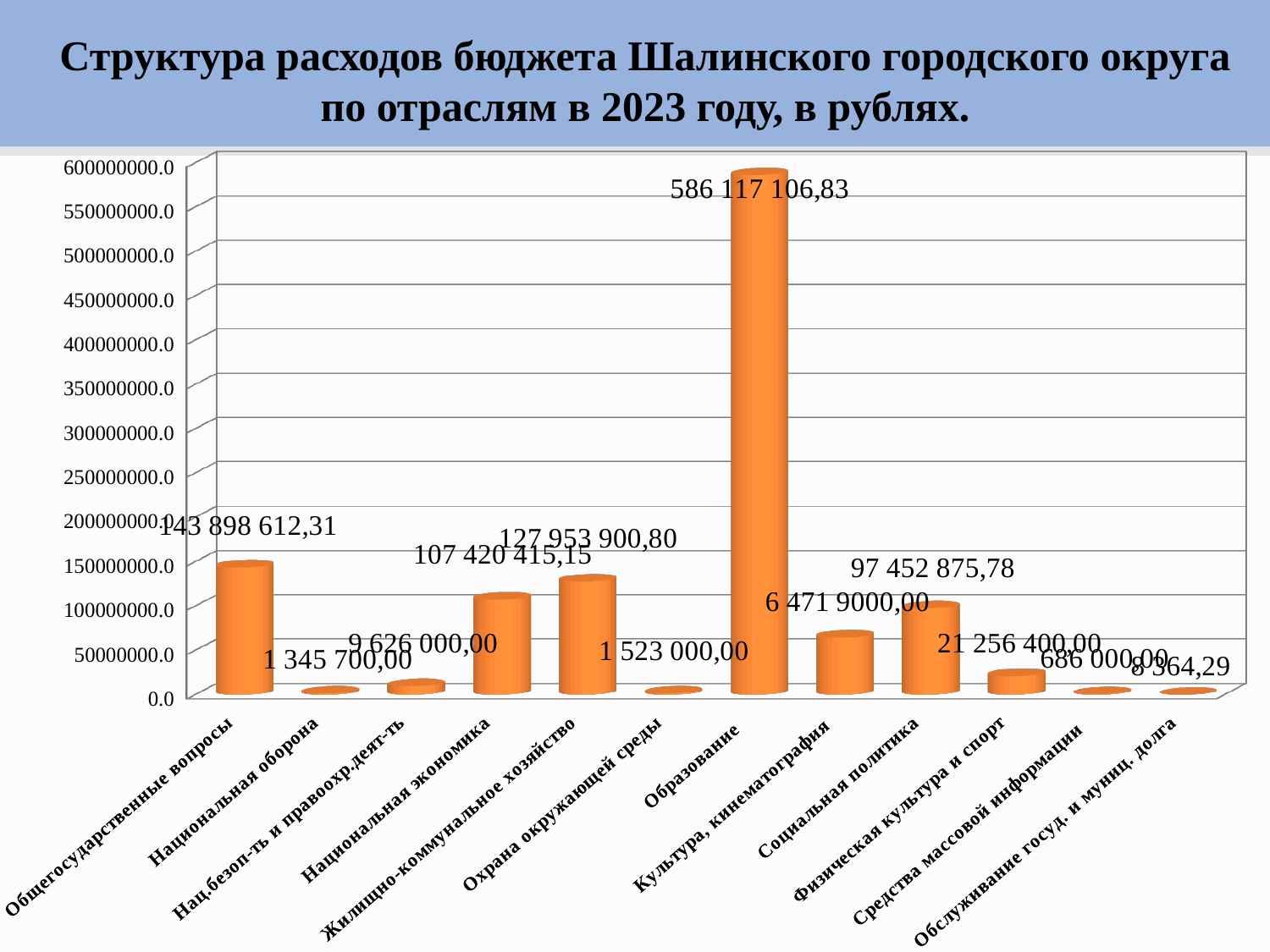
Which category has the lowest expenditure? Обслуживание госуд. и муниц. долга What is the value for Общегосударственные вопросы? 143 898 612,31 Is the value for Образование greater or less than 550000000? greater Which category has the highest expenditure? Образование How many categories (отрасли) are shown on the chart? 12 What is the value for Физическая культура и спорт? 21 256 400,00 Which is larger: Национальная оборона or Охрана окружающей среды? Охрана окружающей среды What is the title of the chart? Структура расходов бюджета Шалинского городского округа по отраслям в 2023 году, в рублях. What is the value for Средства массовой информации? 686 000,00 What is the difference between Общегосударственные вопросы and Национальная экономика? 36 478 197,16 What type of chart is shown on the slide? bar chart What is the value for Образование? 586 117 106,83